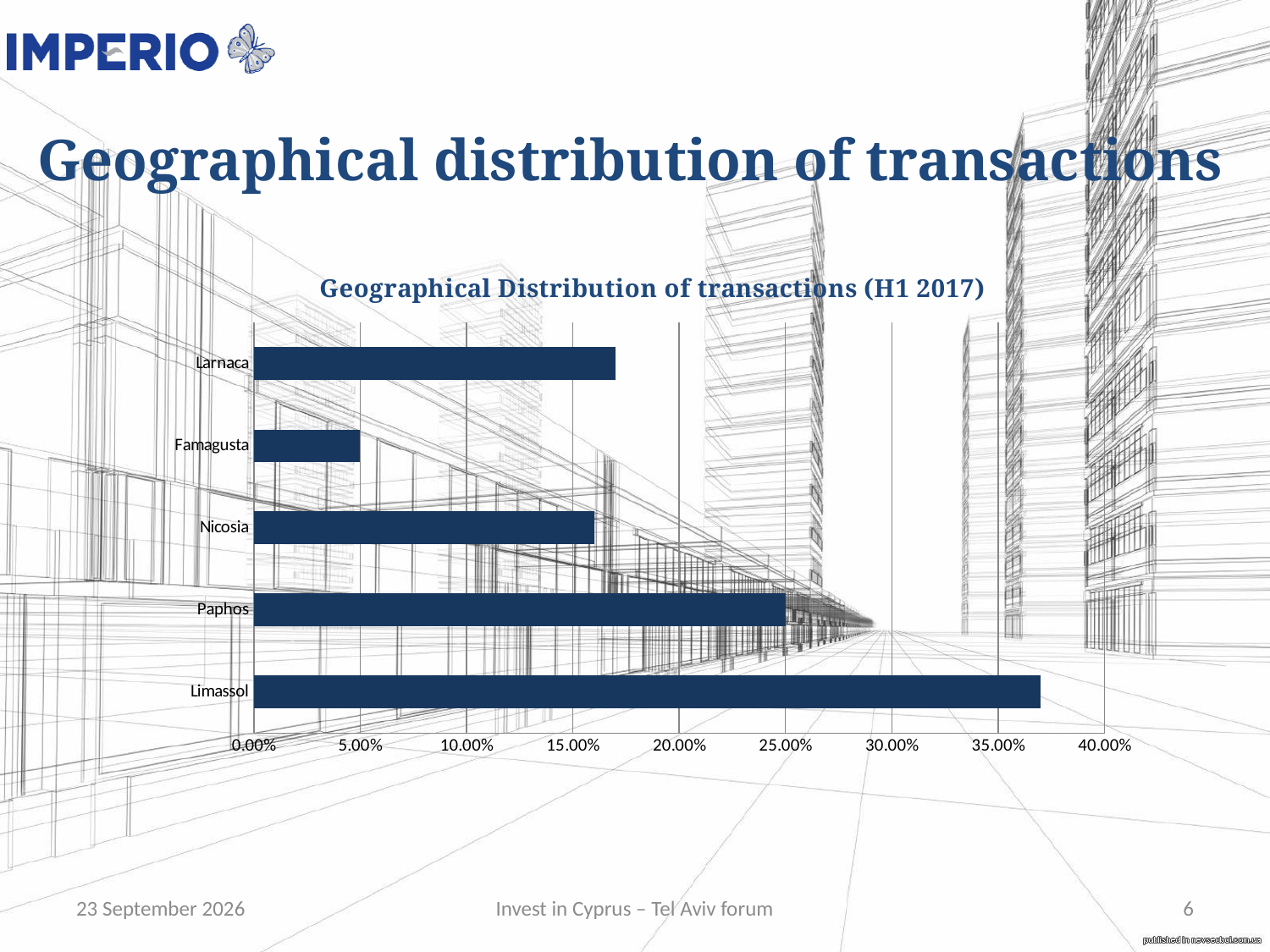
Is the value for Famagusta greater or less than 10.00%? less Is the value for Limassol greater or less than 40.00%? less What is the title of the chart? Geographical Distribution of transactions (H1 2017) Is the value for Larnaca greater or less than 20.00%? less Which city has the lowest share of transactions? Famagusta How many categories (cities) are shown in the chart? 5 Which has a larger share of transactions, Paphos or Larnaca? Paphos What kind of chart is shown on the slide? Bar chart Which city has the highest share of transactions? Limassol Which has a larger share of transactions, Famagusta or Nicosia? Nicosia